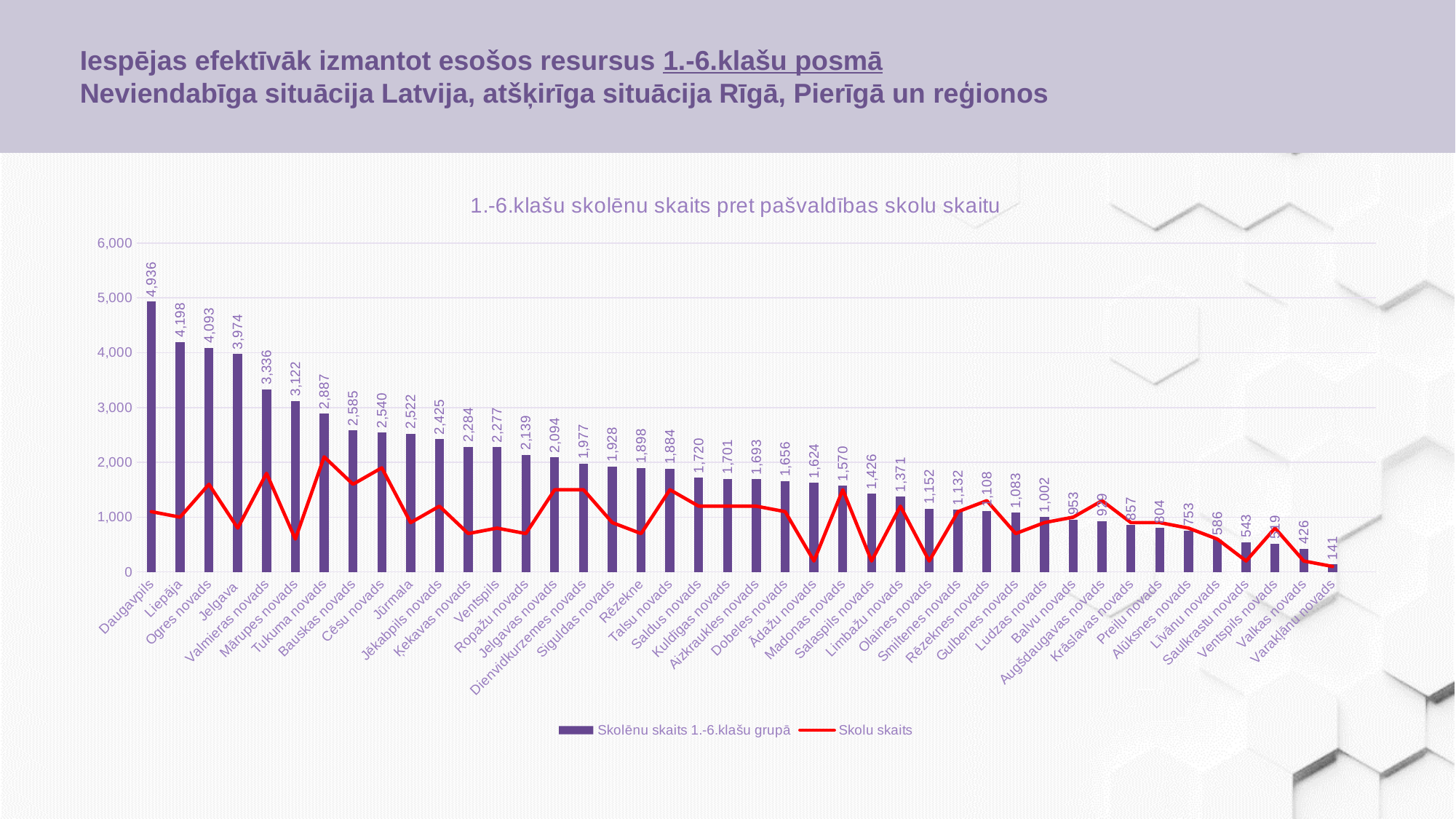
Which category has the highest bar value? Daugavpils Do the bar values rise or fall from left to right along the x axis? fall How many series does the legend list? 2 What is the difference between the bar values for Liepāja and Ogres novads? 105 Is the bar value for Jelgava greater or less than 4,000? less Which category has the lowest bar value? Varakļānu novads Which has a larger bar value, Cēsu novads or Jūrmala? Cēsu novads What is the value for Tukuma novads in the 'Skolēnu skaits 1.-6.klašu grupā' series? 2,887 How many categories are shown on the x axis? 42 What kind of chart is shown? bar chart with a line overlay What is the value for Daugavpils in the 'Skolēnu skaits 1.-6.klašu grupā' series? 4,936 What is the value for Varakļānu novads in the 'Skolēnu skaits 1.-6.klašu grupā' series? 141